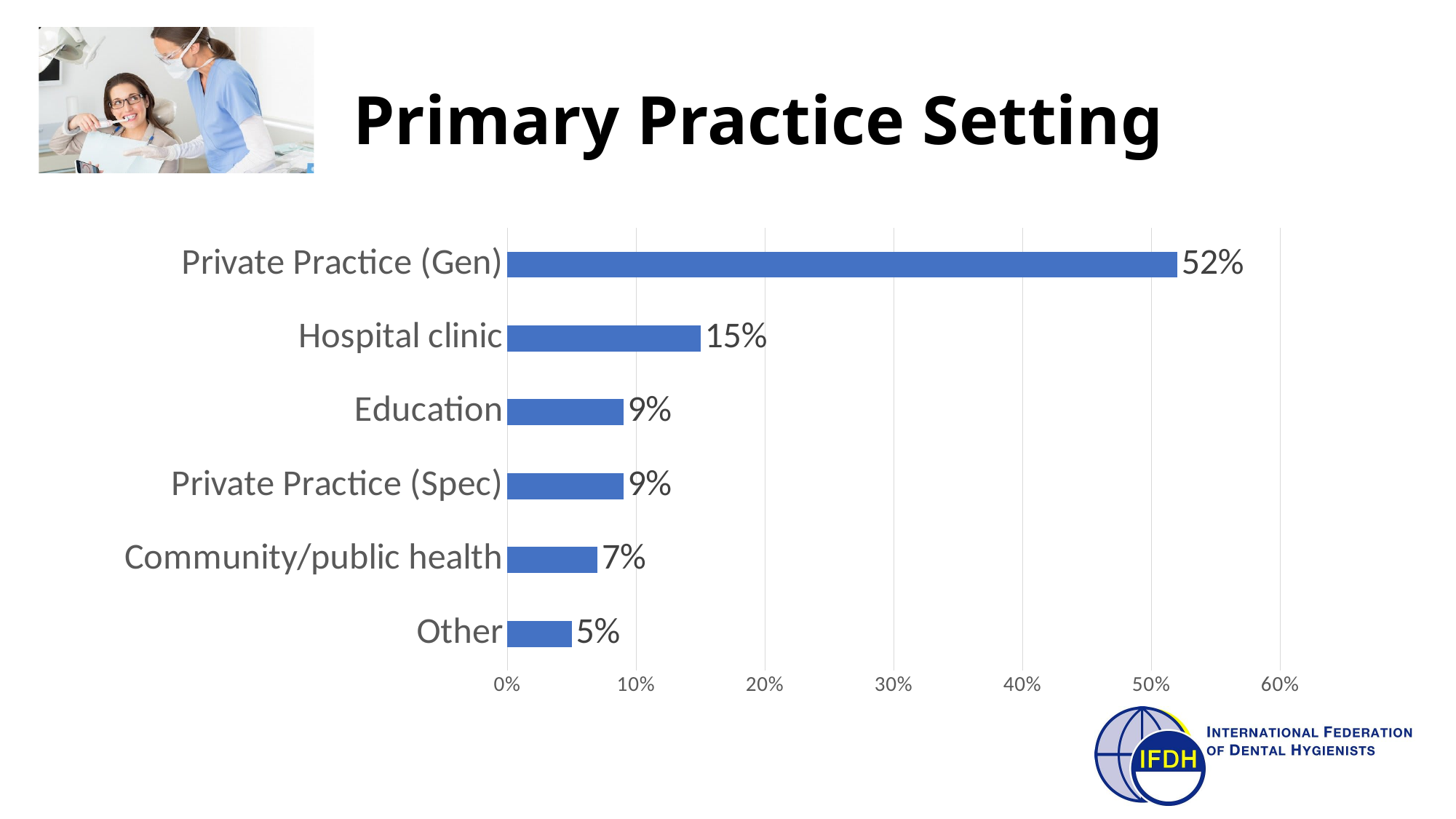
What is the difference between the values for Private Practice (Gen) and Hospital clinic? 37% Which category has the lowest value? Other Which category has the highest value? Private Practice (Gen) What is the value for Hospital clinic? 15% Is the value for Private Practice (Gen) greater or less than 50%? greater What is the value for Community/public health? 7% What is the difference between the values for Education and Other? 4% How many categories are shown in the chart? 6 Which is larger, the value for Hospital clinic or the value for Community/public health? Hospital clinic What kind of chart is shown on the slide? Bar chart What is the value for Private Practice (Gen)? 52% What is the value for Other? 5%